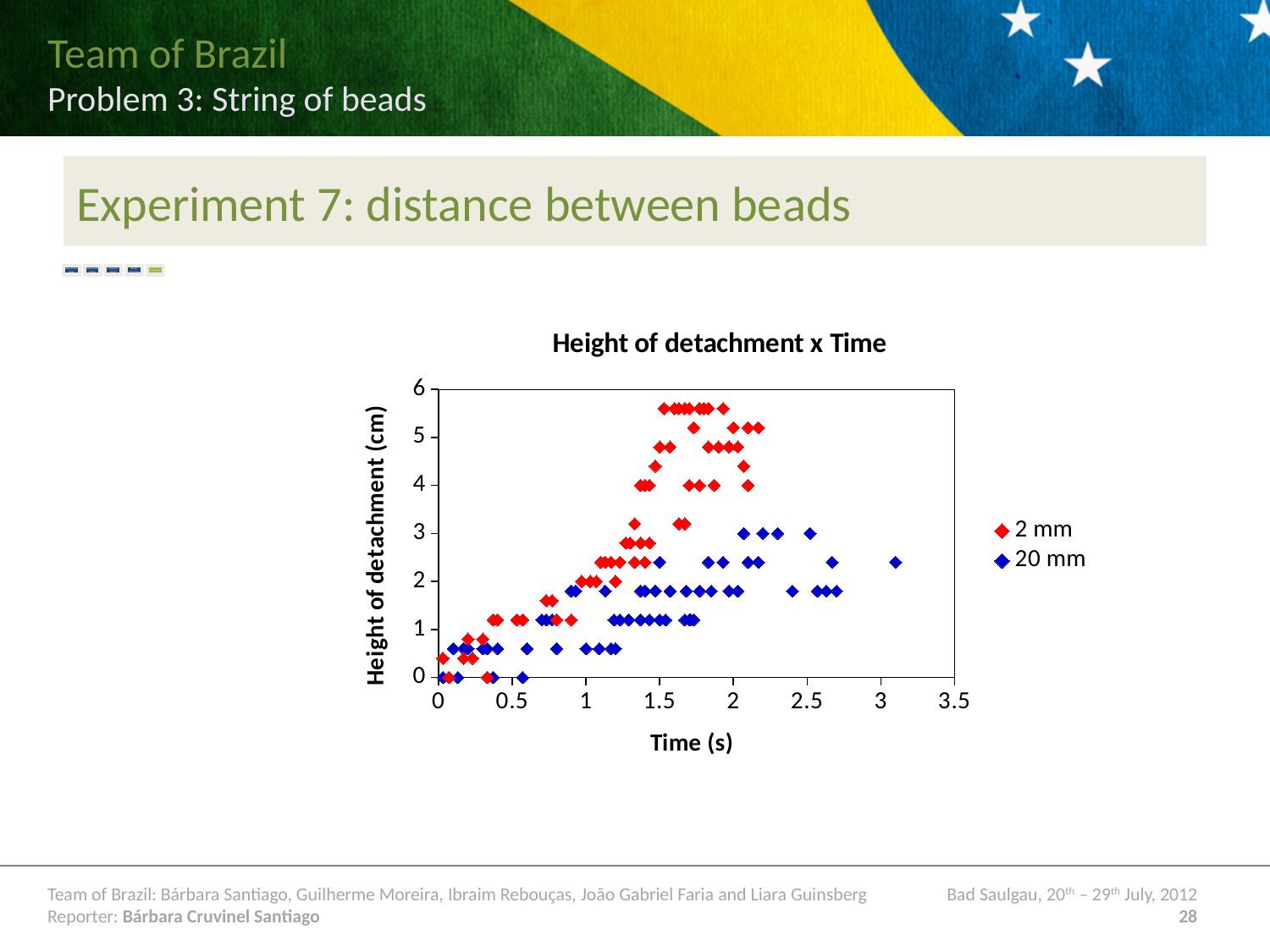
What is the title of the chart? Height of detachment x Time Is the highest height of detachment for the 2 mm series greater or less than 5? greater Is the highest height of detachment for the 20 mm series greater or less than 4? less Which series reaches the greater height of detachment, 2 mm or 20 mm? 2 mm Which series extends to the later times on the x axis, 2 mm or 20 mm? 20 mm How many series does the legend list? 2 What are the two series named in the legend? 2 mm and 20 mm Does the height of detachment generally rise or fall as time increases? rise Is the latest time recorded for the 20 mm series greater or less than 3? greater What is the maximum value shown on the y axis? 6 What kind of chart is shown on the slide? Scatter chart